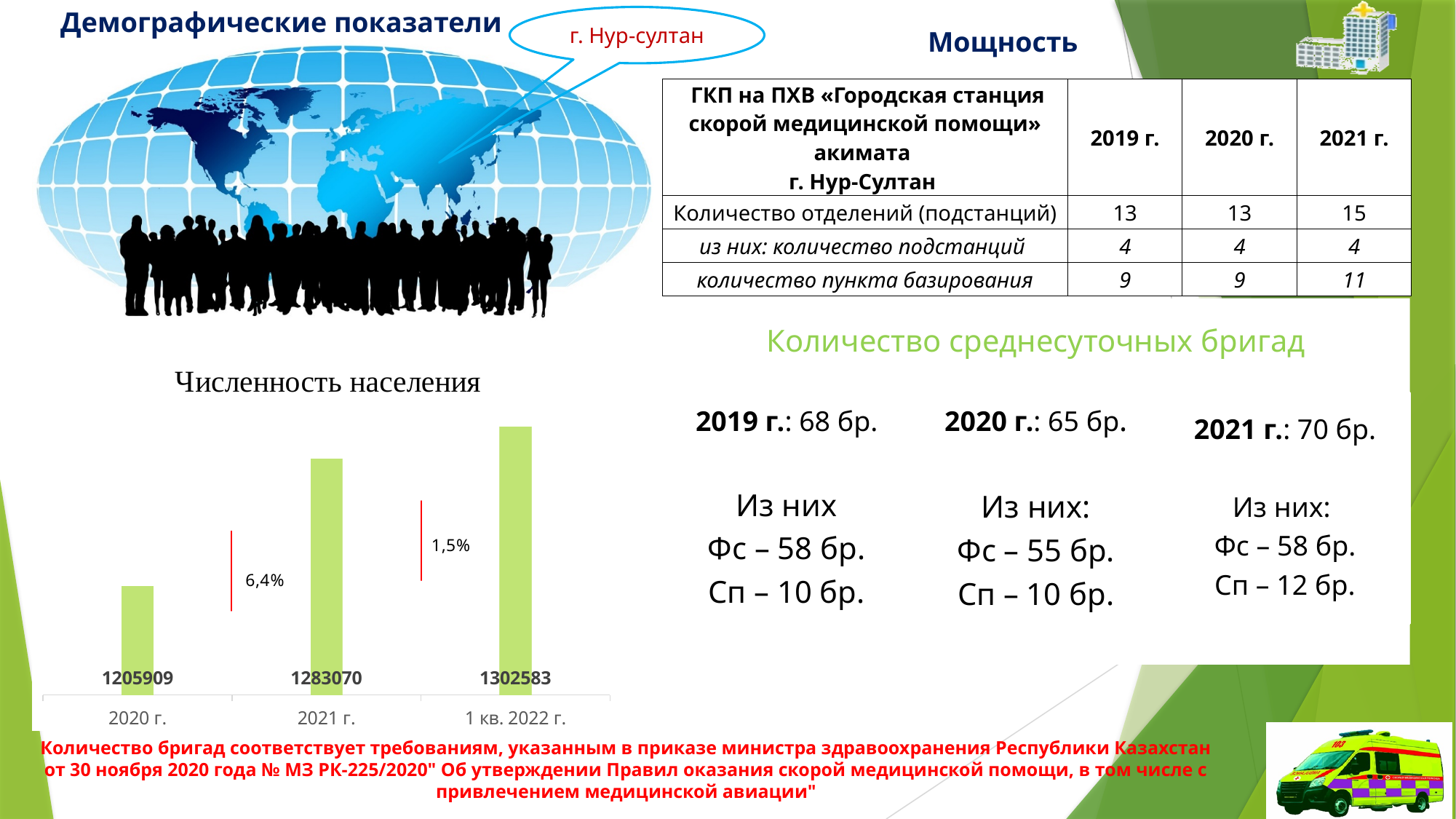
Which period has the lowest value in the Численность населения chart? 2020 г. What is the population value shown for 2020 г. in the Численность населения chart? 1205909 By how much did the population increase from 2020 г. to 2021 г. according to the Численность населения chart? 77161 Which period has the highest value in the Численность населения chart? 1 кв. 2022 г. What is the population value shown for 1 кв. 2022 г. in the Численность населения chart? 1302583 What percentage growth is annotated between the 2020 г. and 2021 г. bars in the Численность населения chart? 6,4% What is the difference between the values for 1 кв. 2022 г. and 2021 г. in the Численность населения chart? 19513 In the Численность населения chart, which is larger: the value for 2021 г. or the value for 2020 г.? 2021 г. Do the values in the Численность населения chart rise or fall from 2020 г. to 1 кв. 2022 г.? rise What is the population value shown for 2021 г. in the Численность населения chart? 1283070 How many bars are shown in the Численность населения chart? 3 What type of chart is the Численность населения chart? bar chart